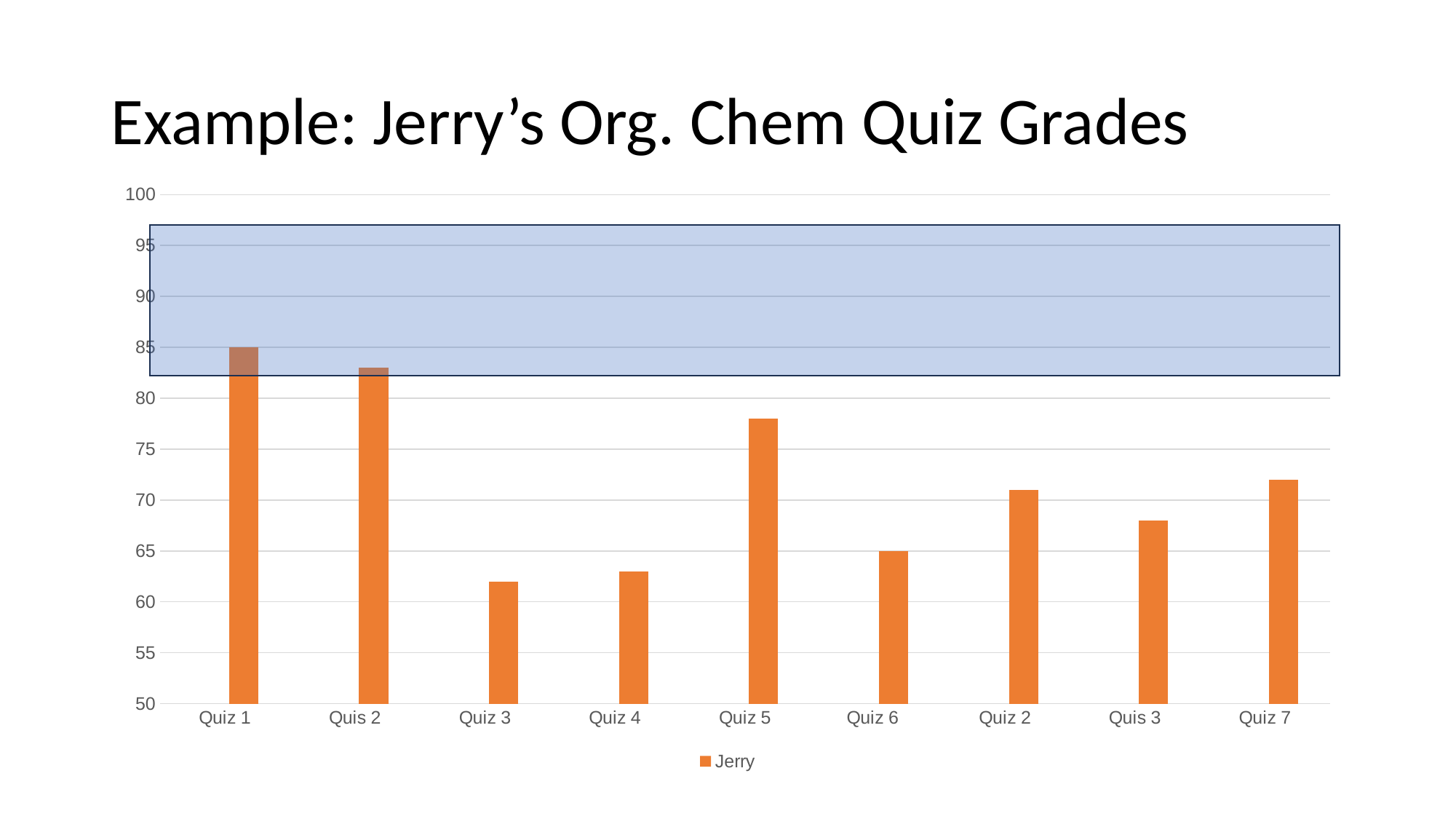
Is the value for Quis 2 greater or less than 80? greater What is the name of the series shown in the legend? Jerry What type of chart is shown on the slide? bar chart Which is larger, the grade for Quiz 5 or the grade for Quiz 7? Quiz 5 Is the value for Quiz 5 greater or less than 75? greater Which quiz has the highest grade? Quiz 1 What is the grade for Quiz 6? 65 How many series does the legend list? 1 How many quiz categories are shown on the x axis? 9 What is the grade for Quiz 1? 85 Which is larger, the grade for Quiz 6 or the grade for Quis 3? Quis 3 Is the value for Quiz 3 greater or less than 65? less